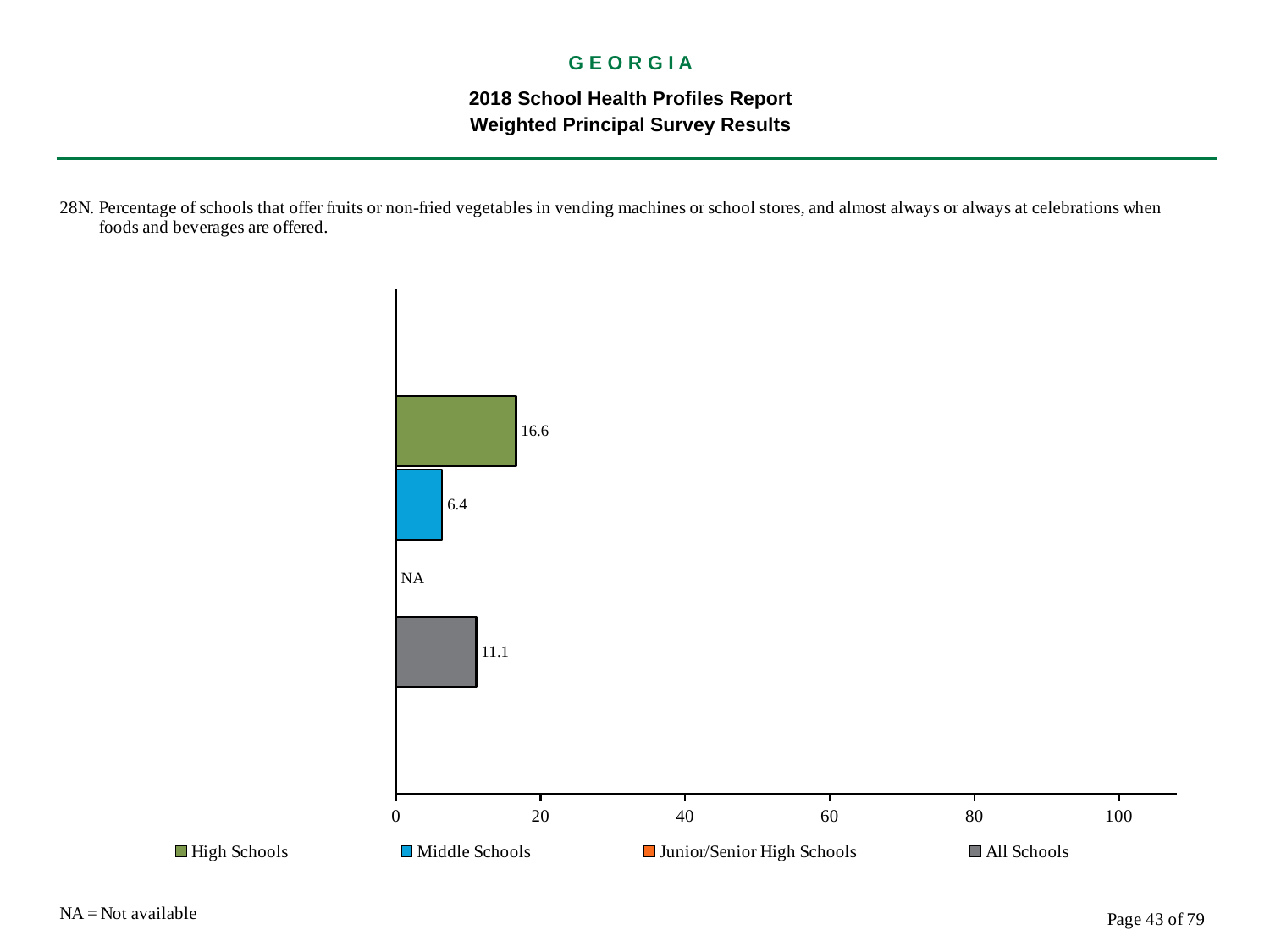
What is the value for All Schools? 11.1 How many series does the legend list? 4 What is the value for High Schools? 16.6 Which school type with a plotted value has the lowest value? Middle Schools Which is larger, the value for Middle Schools or the value for All Schools? All Schools What is the value for Middle Schools? 6.4 What is shown for Junior/Senior High Schools? NA Which school type has the highest value? High Schools Is the value for High Schools greater or less than 20? less What is the difference between the High Schools value and the Middle Schools value? 10.2 What is the difference between the High Schools value and the All Schools value? 5.5 What kind of chart is shown on the slide? bar chart